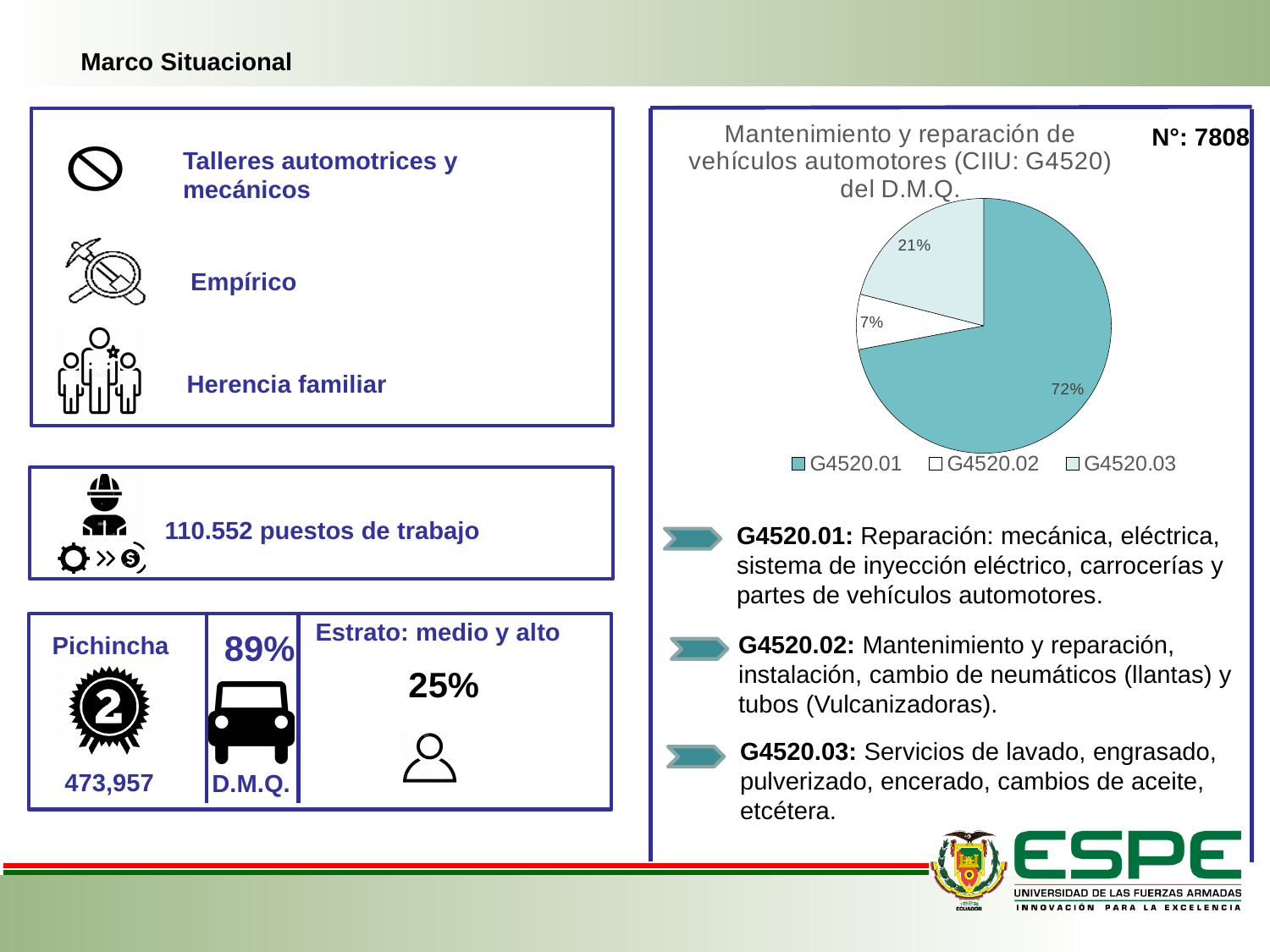
What share of the pie does G4520.03 have? 21% What is the difference in percentage points between the G4520.01 and G4520.03 slices? 51 What type of chart is shown on the slide? pie chart How many entries does the legend of the pie chart list? 3 Which category has the smallest slice of the pie? G4520.02 Which slice is larger, G4520.02 or G4520.03? G4520.03 What is the title of the pie chart? Mantenimiento y reparación de vehículos automotores (CIIU: G4520) del D.M.Q. What share of the pie does G4520.01 have? 72% Which category has the largest slice of the pie? G4520.01 What is the difference in percentage points between the G4520.03 and G4520.02 slices? 14 How many slices does the pie chart have? 3 What share of the pie does G4520.02 have? 7%